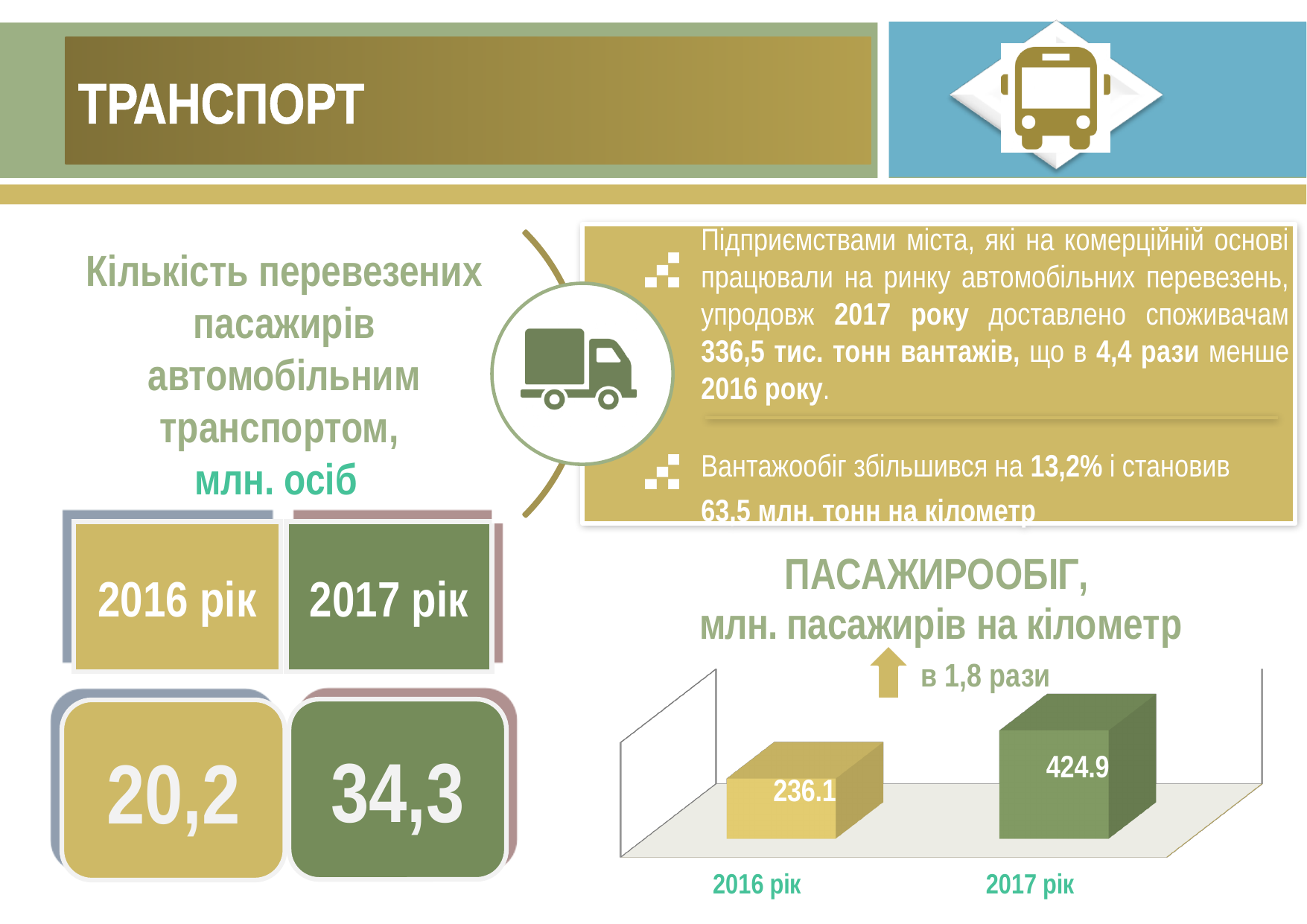
In the ПАСАЖИРООБІГ chart, is the value for 2017 рік larger or smaller than the value for 2016 рік? larger Do the values in the ПАСАЖИРООБІГ chart rise or fall from 2016 рік to 2017 рік? rise What is the value for 2016 рік in the ПАСАЖИРООБІГ chart? 236.1 What is the difference between the 2017 рік and 2016 рік values in the ПАСАЖИРООБІГ chart? 188.8 What kind of chart is the ПАСАЖИРООБІГ chart? bar chart How many categories are shown in the ПАСАЖИРООБІГ chart? 2 What unit is given in the title of the ПАСАЖИРООБІГ chart? млн. пасажирів на кілометр Which year has the lowest value in the ПАСАЖИРООБІГ chart? 2016 рік Which year has the highest value in the ПАСАЖИРООБІГ chart? 2017 рік What is the value for 2017 рік in the ПАСАЖИРООБІГ chart? 424.9 What colour is the bar for 2017 рік in the ПАСАЖИРООБІГ chart? green